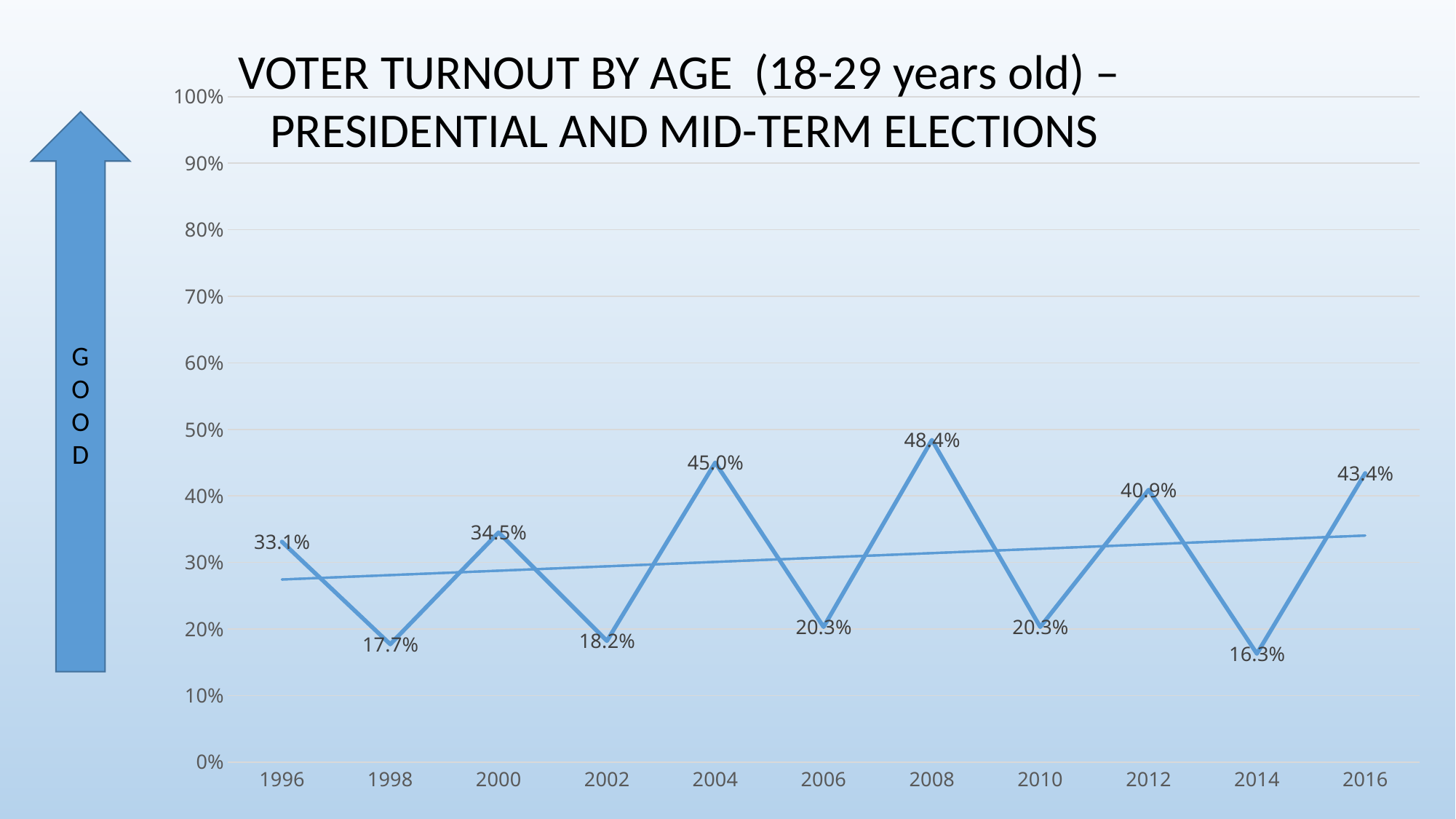
Which year had a higher voter turnout, 2004 or 2016? 2004 How many election years are plotted on the chart? 11 Which year had the lowest voter turnout for 18-29 year olds? 2014 What is the title of the chart? VOTER TURNOUT BY AGE (18-29 years old) – PRESIDENTIAL AND MID-TERM ELECTIONS Is the voter turnout for 2012 greater or less than 40%? greater What is the difference in voter turnout between 2008 and 2014? 32.1% What was the voter turnout for 18-29 year olds in 2008? 48.4% Which year had the highest voter turnout for 18-29 year olds? 2008 What kind of chart is shown on the slide? Line chart What was the voter turnout for 18-29 year olds in 1996? 33.1% What is the difference in voter turnout between 2016 and 2012? 2.5% What was the voter turnout for 18-29 year olds in 2014? 16.3%